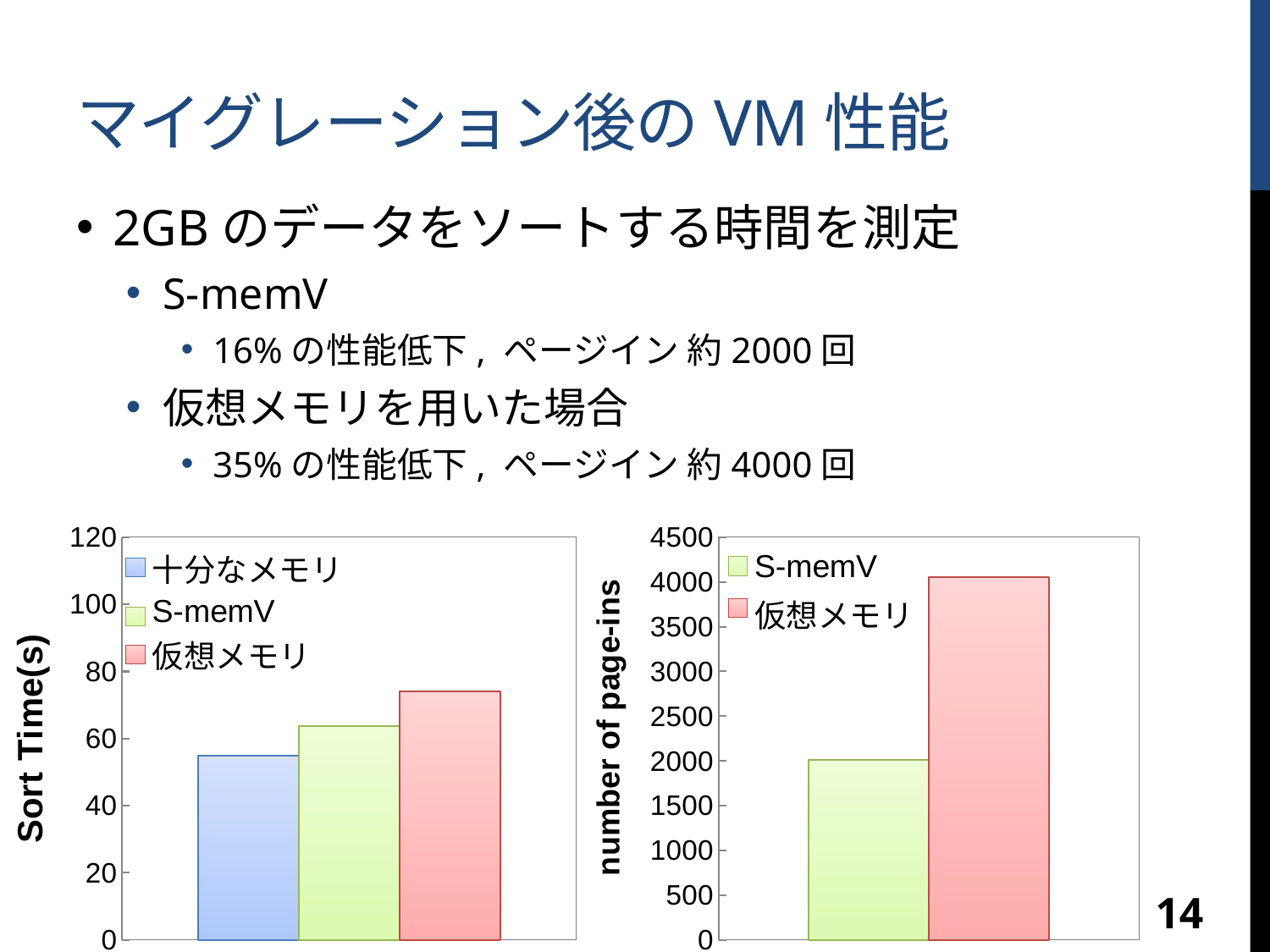
In the left chart (Sort Time(s)), is the value for S-memV greater or less than 60? greater What kind of chart is the left chart with the y-axis labelled Sort Time(s)? bar chart What is the y-axis label of the right chart? number of page-ins In the left chart (Sort Time(s)), is the value for 仮想メモリ greater or less than 80? less In the left chart (Sort Time(s)), which series has the highest bar? 仮想メモリ How many series does the legend of the left chart (Sort Time(s)) list? 3 How many series does the legend of the right chart (number of page-ins) list? 2 In the left chart (Sort Time(s)), is the value for 十分なメモリ greater or less than 60? less In the right chart (number of page-ins), which series has the higher bar? 仮想メモリ In the left chart (Sort Time(s)), which series has the lowest bar? 十分なメモリ